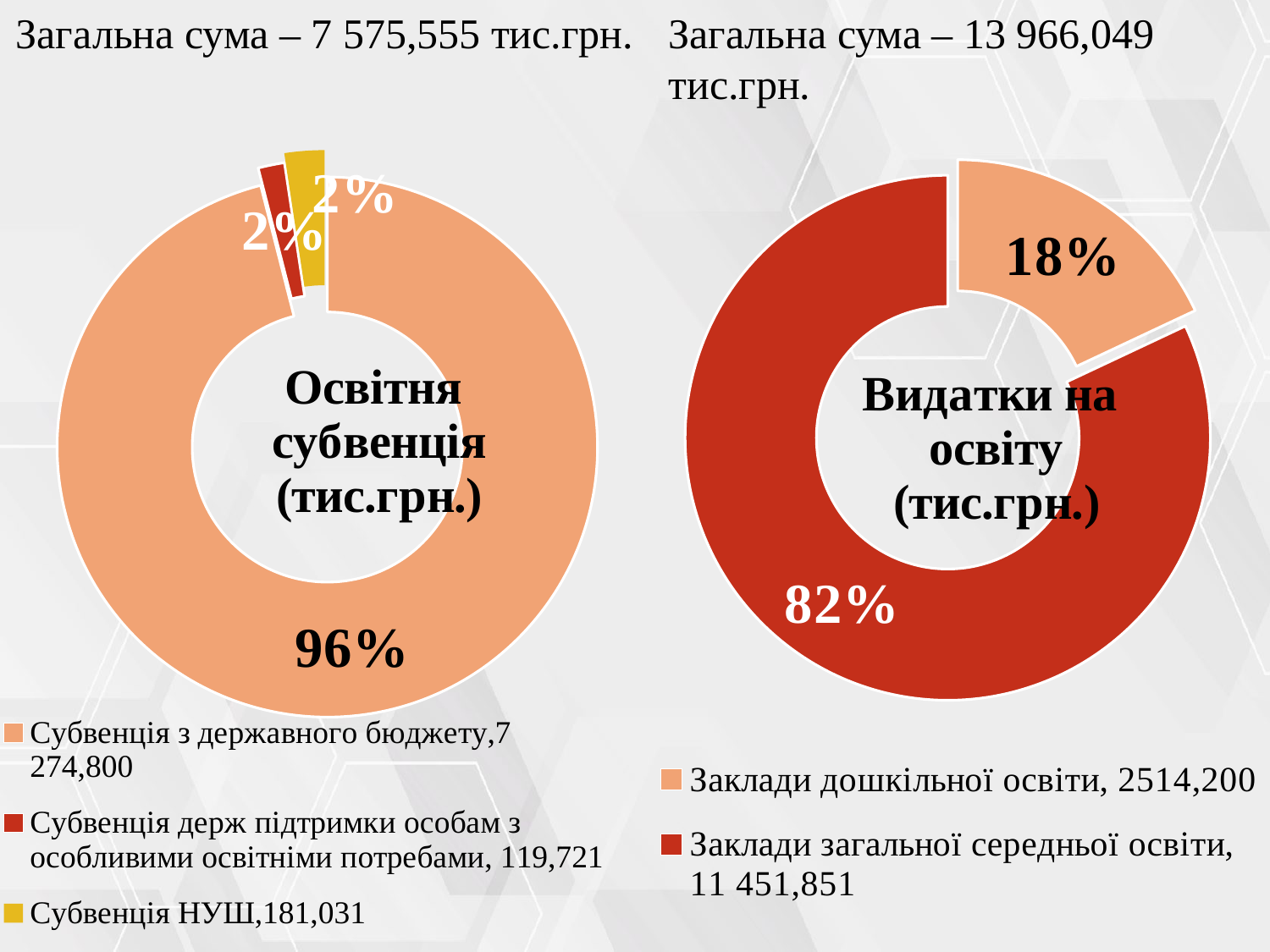
In the chart titled 'Освітня субвенція (тис.грн.)', what is the value shown in the legend for 'Субвенція держ підтримки особам з особливими освітніми потребами'? 119,721 In the chart titled 'Видатки на освіту (тис.грн.)', what share does 'Заклади дошкільної освіти' represent? 18% In the chart titled 'Видатки на освіту (тис.грн.)', which category has the smallest slice? Заклади дошкільної освіти In the chart titled 'Видатки на освіту (тис.грн.)', what is the value shown in the legend for 'Заклади дошкільної освіти'? 2514,200 How many categories does the legend of the chart titled 'Освітня субвенція (тис.грн.)' list? 3 In the chart titled 'Видатки на освіту (тис.грн.)', what is the difference between the values for 'Заклади загальної середньої освіти' and 'Заклади дошкільної освіти'? 8 937,651 In the chart titled 'Освітня субвенція (тис.грн.)', what is the value shown in the legend for 'Субвенція НУШ'? 181,031 In the chart titled 'Освітня субвенція (тис.грн.)', which is larger: 'Субвенція НУШ' or 'Субвенція держ підтримки особам з особливими освітніми потребами'? Субвенція НУШ What kind of chart is the chart titled 'Видатки на освіту (тис.грн.)'? doughnut chart In the chart titled 'Освітня субвенція (тис.грн.)', which category has the largest slice? Субвенція з державного бюджету In the chart titled 'Освітня субвенція (тис.грн.)', what share of the total does 'Субвенція з державного бюджету' represent? 96% In the chart titled 'Видатки на освіту (тис.грн.)', what share does 'Заклади загальної середньої освіти' represent? 82%